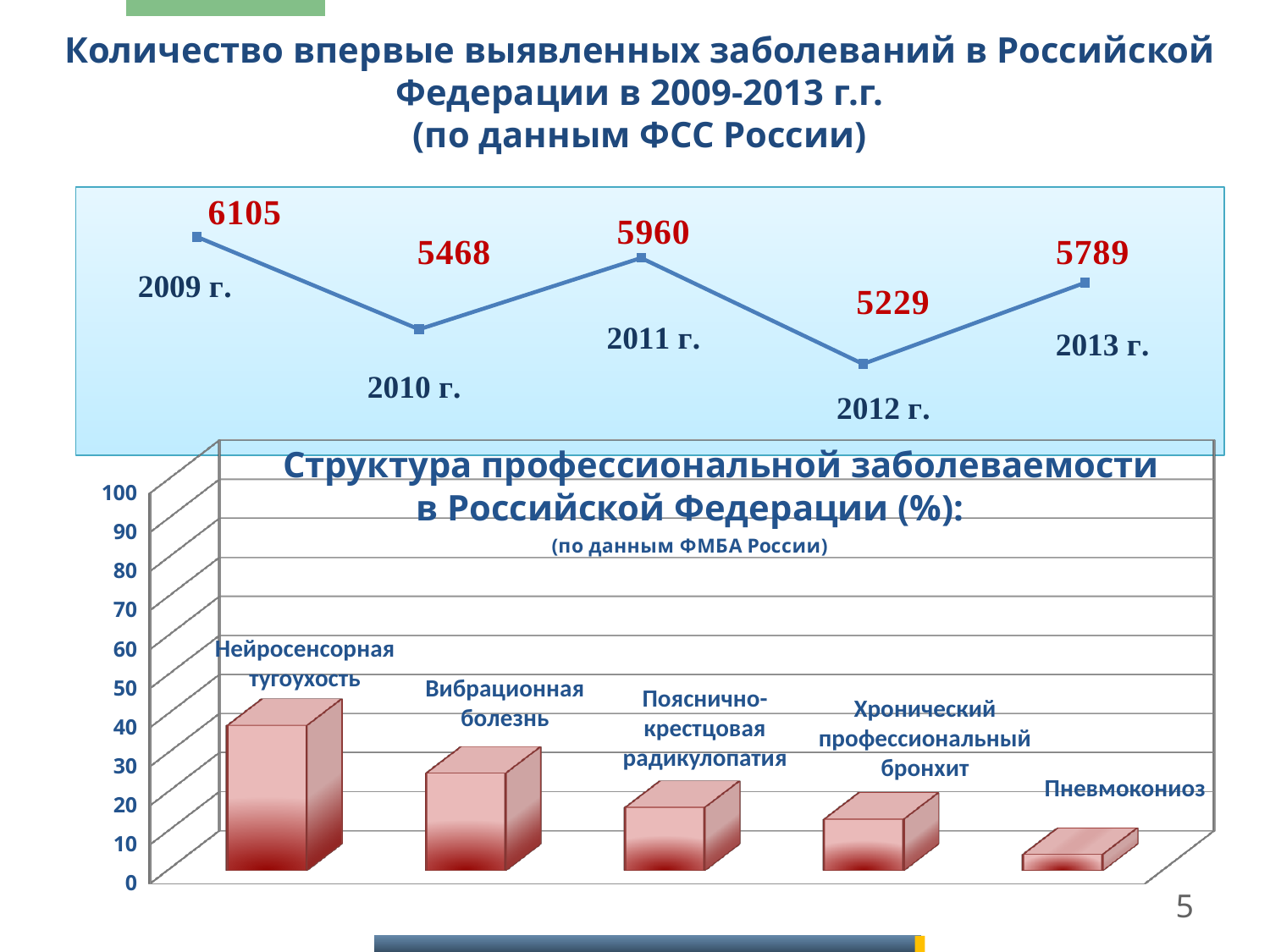
What kind of chart is the bottom chart titled 'Структура профессиональной заболеваемости в Российской Федерации (%)'? bar chart On the top line chart, which year has the highest value? 2009 On the top line chart, what is the value for 2012? 5229 On the top line chart, what is the value for 2009? 6105 On the bottom bar chart, which category has the lowest value? Пневмокониоз On the top line chart, which is larger: the value for 2011 or the value for 2013? 2011 On the bottom bar chart, which category has the highest value? Нейросенсорная тугоухость On the top line chart, how many years are plotted? 5 On the top line chart, what is the difference between the 2009 value and the 2012 value? 876 On the top line chart, which year has the lowest value? 2012 On the bottom bar chart, is the value for Пневмокониоз greater or less than 10? less On the top line chart, does the value rise or fall from 2009 to 2010? fall